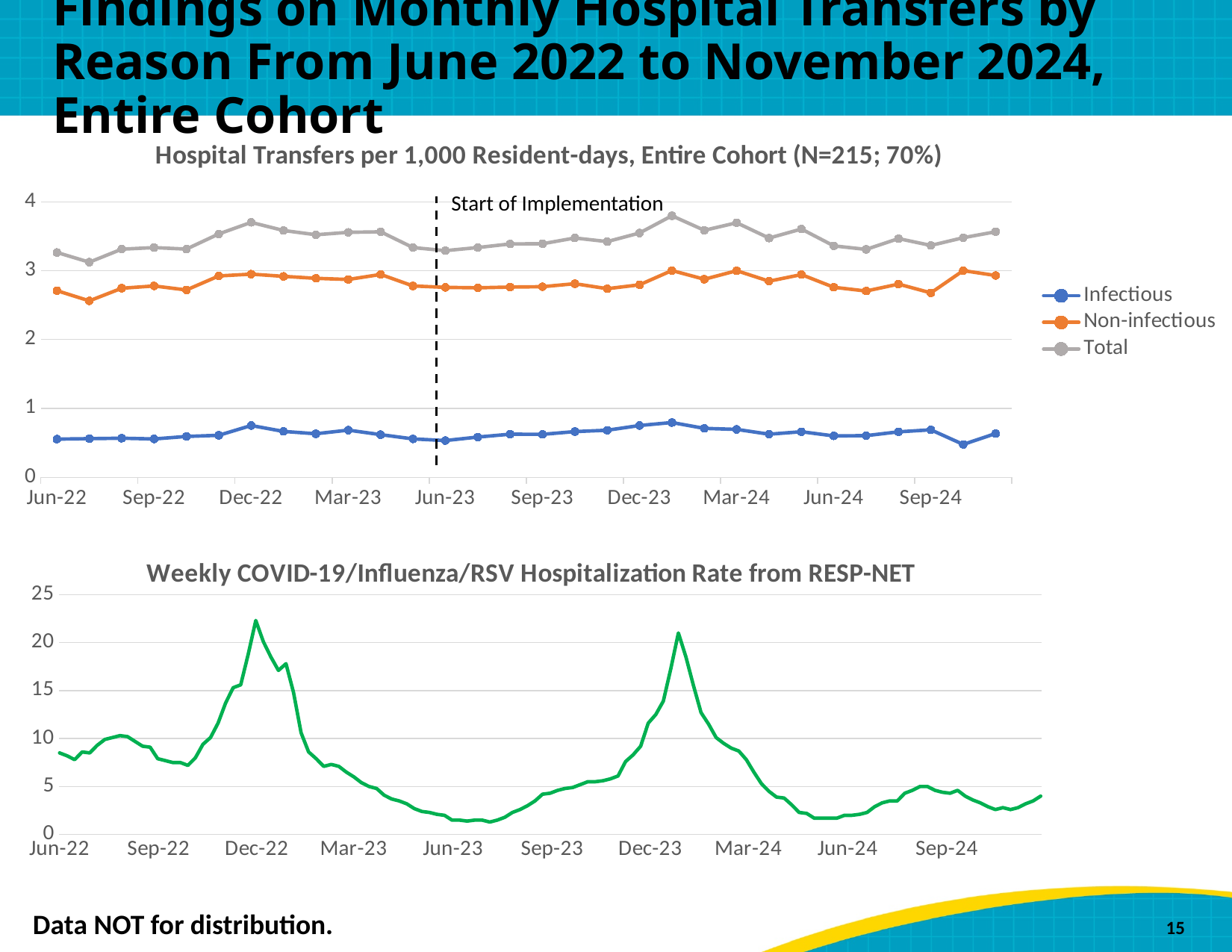
In the top chart (Hospital Transfers per 1,000 Resident-days), is the Infectious value at Jun-22 greater or less than 1? less In the top chart (Hospital Transfers per 1,000 Resident-days), which series has the highest values throughout the period? Total How many series does the legend of the top chart (Hospital Transfers per 1,000 Resident-days) list? 3 In the top chart (Hospital Transfers per 1,000 Resident-days), which series has the lowest values throughout the period? Infectious In the top chart (Hospital Transfers per 1,000 Resident-days), what event does the dashed vertical line mark? Start of Implementation What is the title of the bottom chart? Weekly COVID-19/Influenza/RSV Hospitalization Rate from RESP-NET In the top chart (Hospital Transfers per 1,000 Resident-days), which is larger at Dec-22: the Infectious value or the Non-infectious value? Non-infectious What kind of chart is the top chart titled 'Hospital Transfers per 1,000 Resident-days, Entire Cohort'? Line chart In the bottom chart (Weekly COVID-19/Influenza/RSV Hospitalization Rate from RESP-NET), is the value at Jun-23 greater or less than 5? less In the top chart (Hospital Transfers per 1,000 Resident-days), is the Total value at Jun-22 greater or less than 3? greater